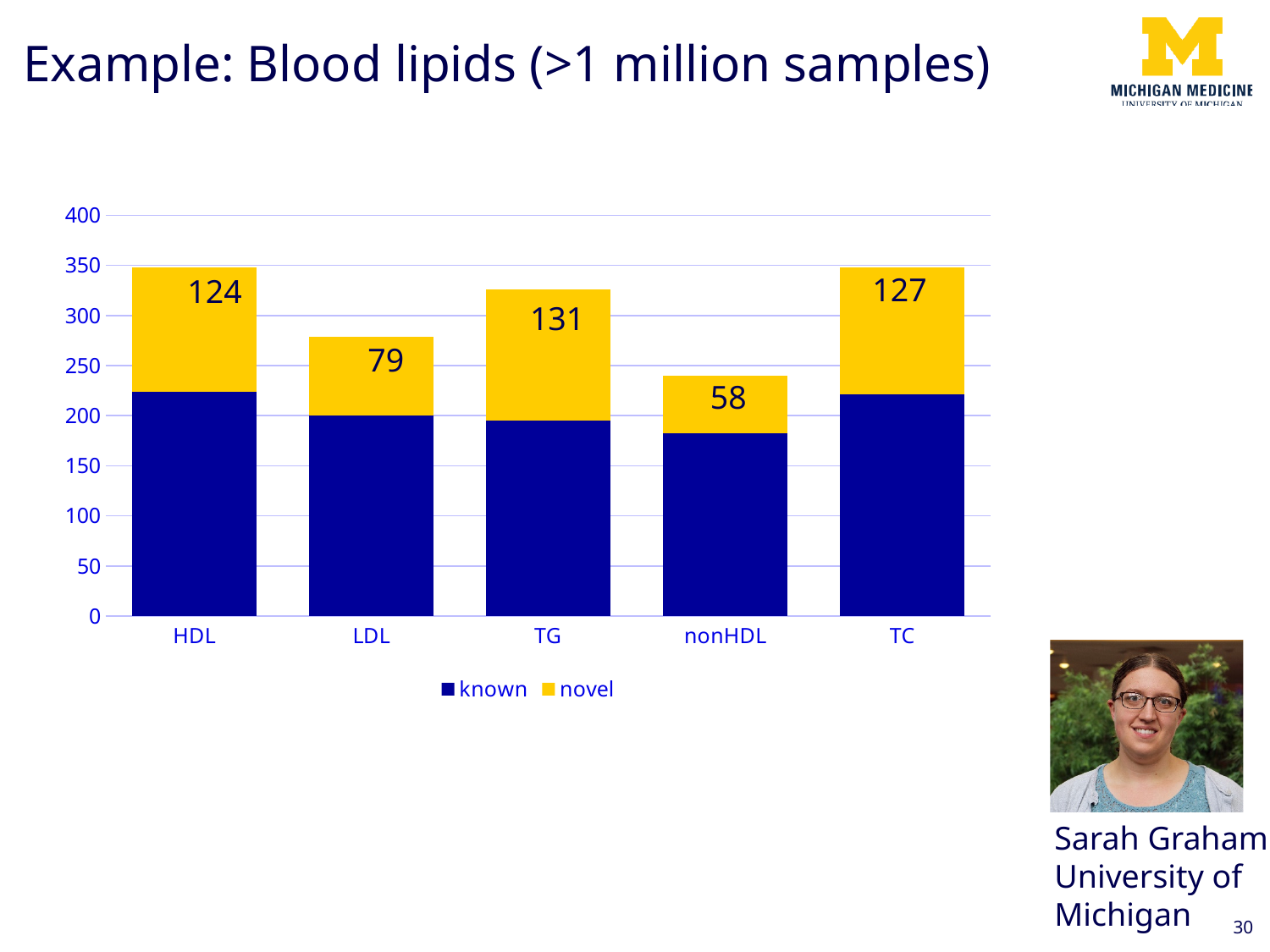
What kind of chart is shown on the slide? Stacked bar chart Which category has the highest novel value? TG What is the novel value for nonHDL? 58 How many series does the legend list? 2 What is the difference between the novel values for TG and nonHDL? 73 What is the novel value for HDL? 124 Is the known value for nonHDL greater or less than 200? less Which category has the lowest novel value? nonHDL Which has a larger novel value, HDL or LDL? HDL Is the known value for HDL greater or less than 200? greater How many categories are shown on the x axis? 5 What is the novel value for TC? 127